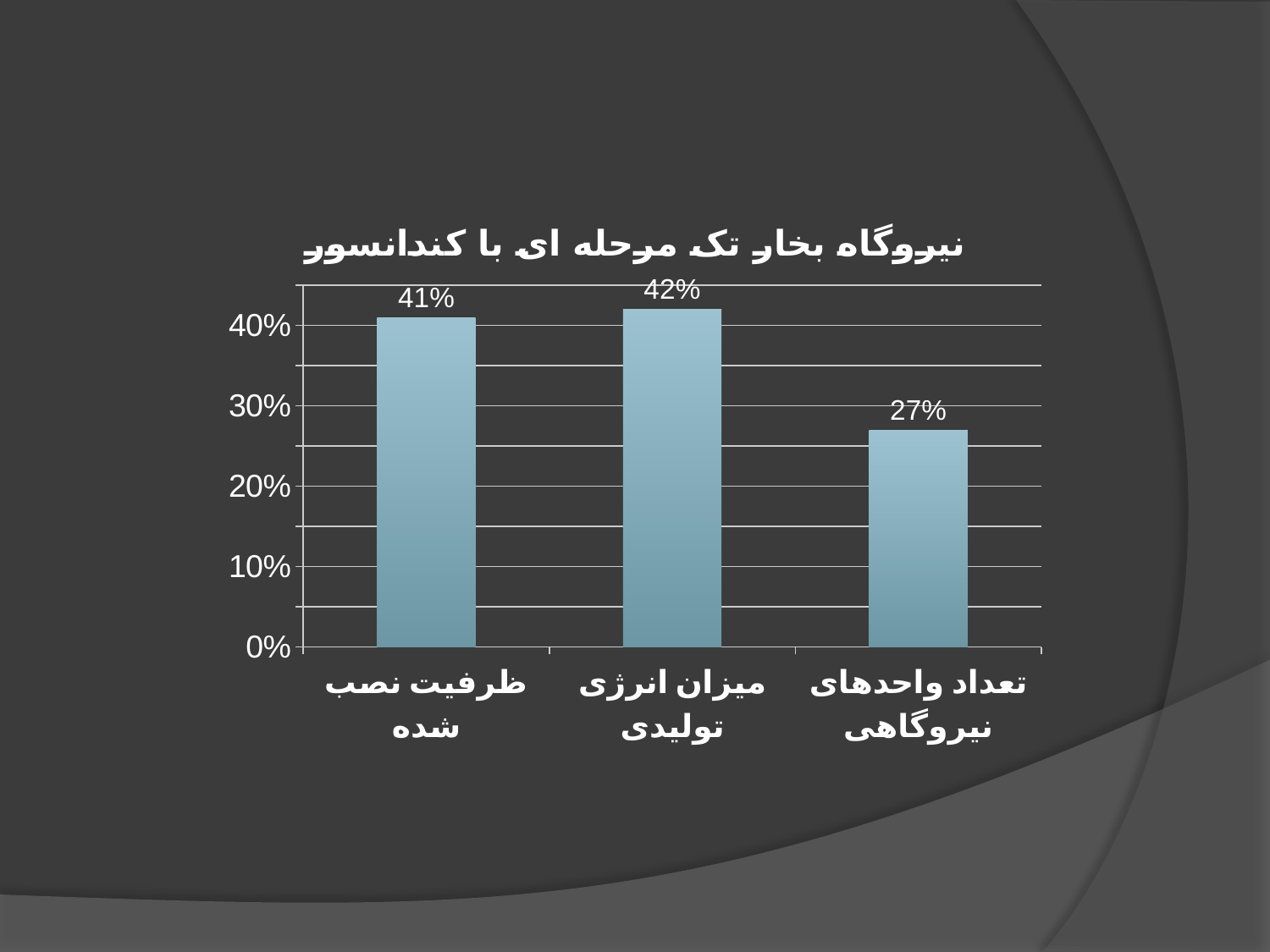
Which category has the lowest value? تعداد واحدهای نیروگاهی What is the value for میزان انرژی تولیدی? 42% What type of chart is shown on the slide? bar chart Which is larger, the value for ظرفیت نصب شده or the value for تعداد واحدهای نیروگاهی? ظرفیت نصب شده How many categories are plotted in the chart? 3 What is the value for ظرفیت نصب شده? 41% Which category has the highest value according to the data labels? میزان انرژی تولیدی What is the difference between the values for میزان انرژی تولیدی and تعداد واحدهای نیروگاهی? 15% What is the value for تعداد واحدهای نیروگاهی? 27% What is the title of the chart? نیروگاه بخار تک مرحله ای با کندانسور Is the value for تعداد واحدهای نیروگاهی greater or less than 30%? less What is the difference between the values for ظرفیت نصب شده and تعداد واحدهای نیروگاهی? 14%